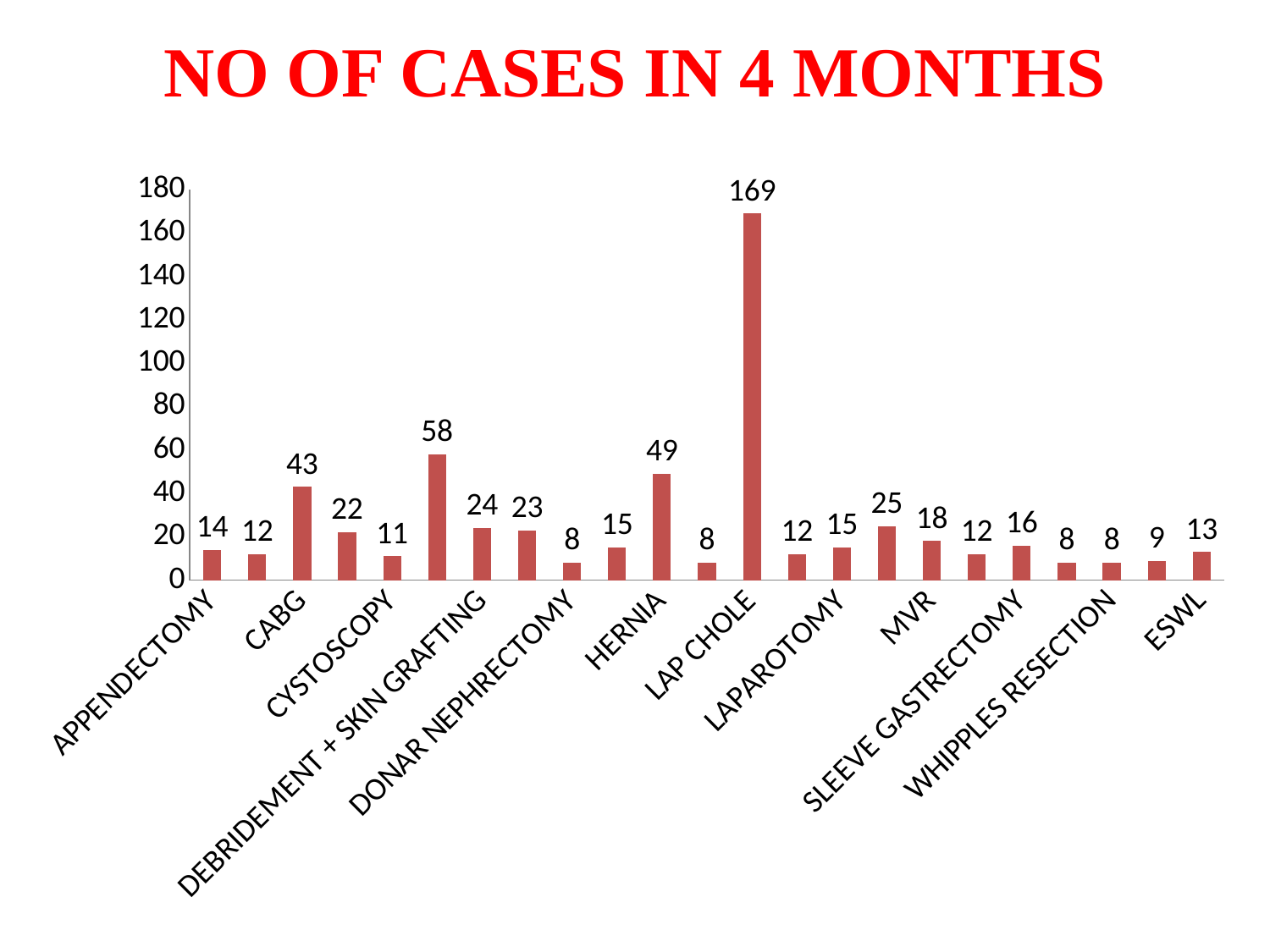
What is the difference in cases between CABG and CYSTOSCOPY? 32 What type of chart is shown on the slide? Bar chart What is the difference in cases between LAP CHOLE and HERNIA? 120 What is the number of cases for CABG? 43 What is the title of the chart? NO OF CASES IN 4 MONTHS Which has more cases, MVR or SLEEVE GASTRECTOMY? MVR Is the value for LAP CHOLE greater or less than 160? greater Which procedure has the highest number of cases? LAP CHOLE What is the number of cases for DEBRIDEMENT + SKIN GRAFTING? 24 What is the number of cases for LAP CHOLE? 169 What is the number of cases for HERNIA? 49 What is the number of cases for ESWL? 13